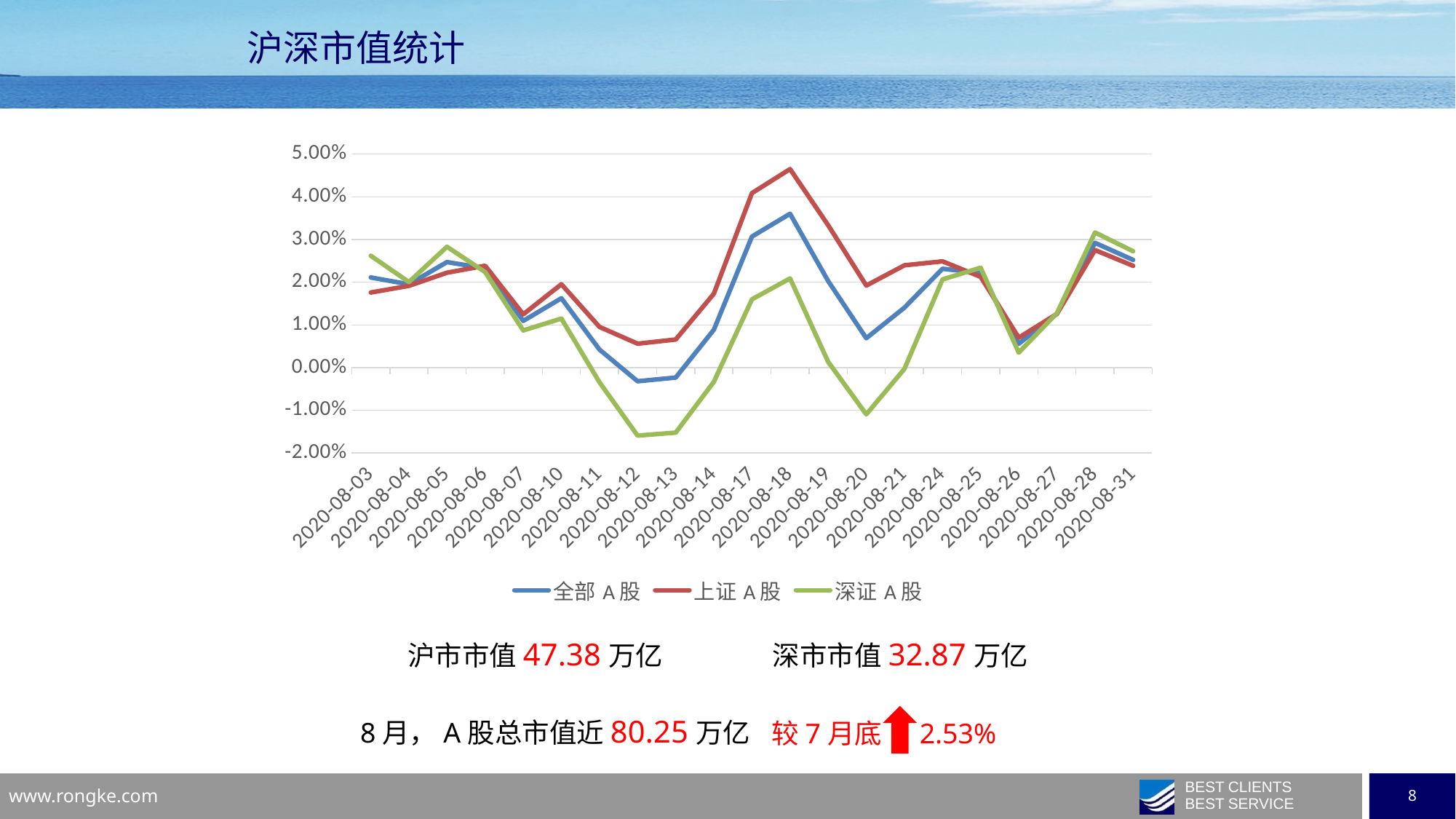
On which date does the 上证 A 股 series reach its highest value? 2020-08-18 Is the value for 深证 A 股 on 2020-08-12 greater or less than -1.00%? less Does the 上证 A 股 series rise or fall from 2020-08-18 to 2020-08-20? fall What kind of chart is shown on the slide? line chart Is the value for 全部 A 股 on 2020-08-18 greater or less than 3.00%? greater Which series has the lowest value on 2020-08-20? 深证 A 股 Which colour is used for the 深证 A 股 series in the chart? green How many dates are plotted along the x axis of the chart? 21 Is the value for 上证 A 股 on 2020-08-18 greater or less than 4.00%? greater On 2020-08-05, which is larger: the value for 深证 A 股 or the value for 上证 A 股? 深证 A 股 Which series has the highest value on 2020-08-12? 上证 A 股 How many series does the chart legend list? 3